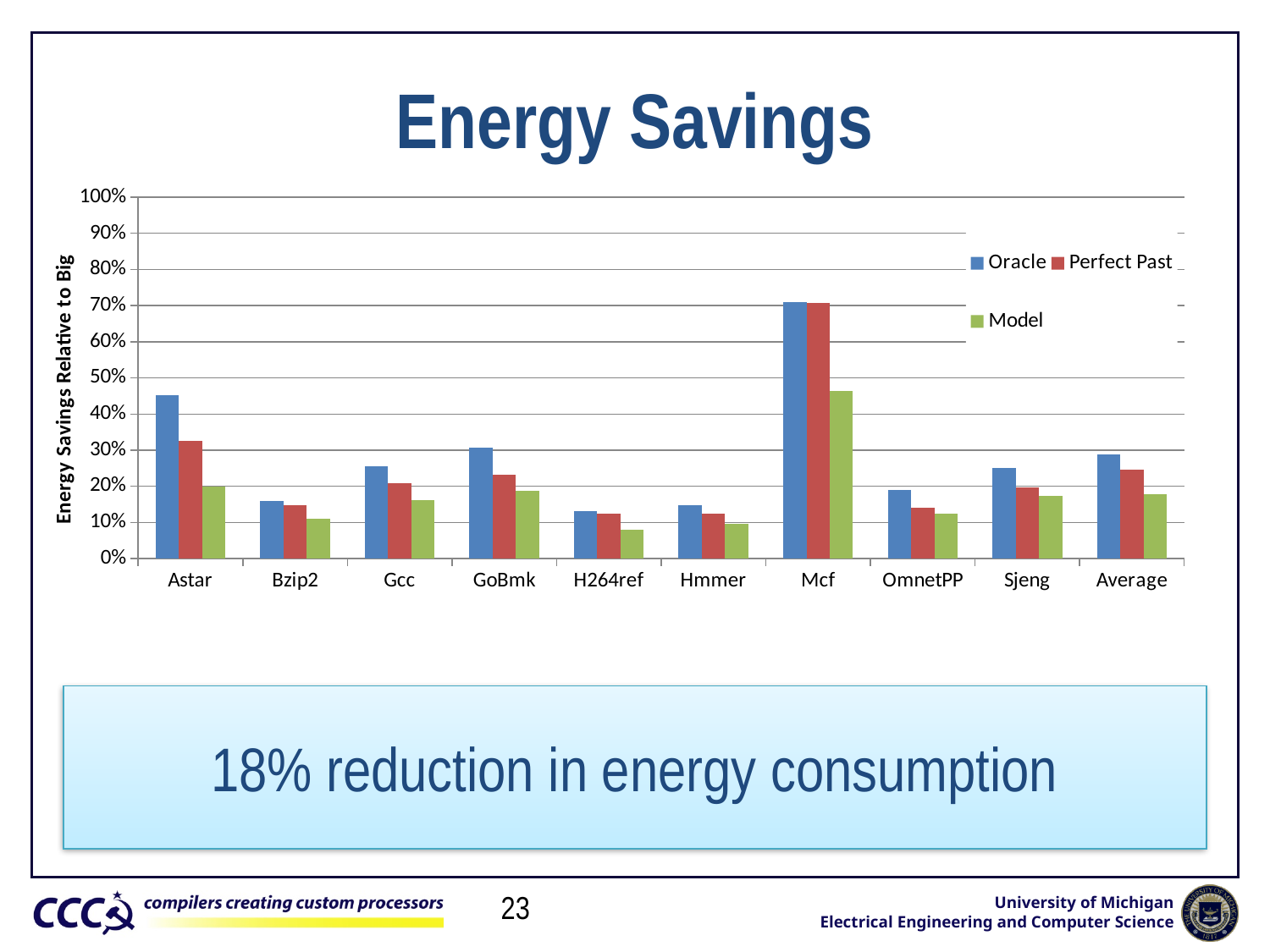
Is the Oracle value for Mcf greater or less than 60%? greater What kind of chart is shown on the slide? bar chart Which category has the highest Oracle value? Mcf Is the Model value for Average greater or less than 20%? less How many categories are shown along the x axis? 10 For Astar, which is larger: the Oracle value or the Perfect Past value? Oracle Is the Oracle value for Astar greater or less than 40%? greater How many series does the legend list? 3 Which is larger: the Oracle value for GoBmk or the Oracle value for Gcc? GoBmk What is the title of the y axis? Energy Savings Relative to Big Which category has the highest Model value? Mcf